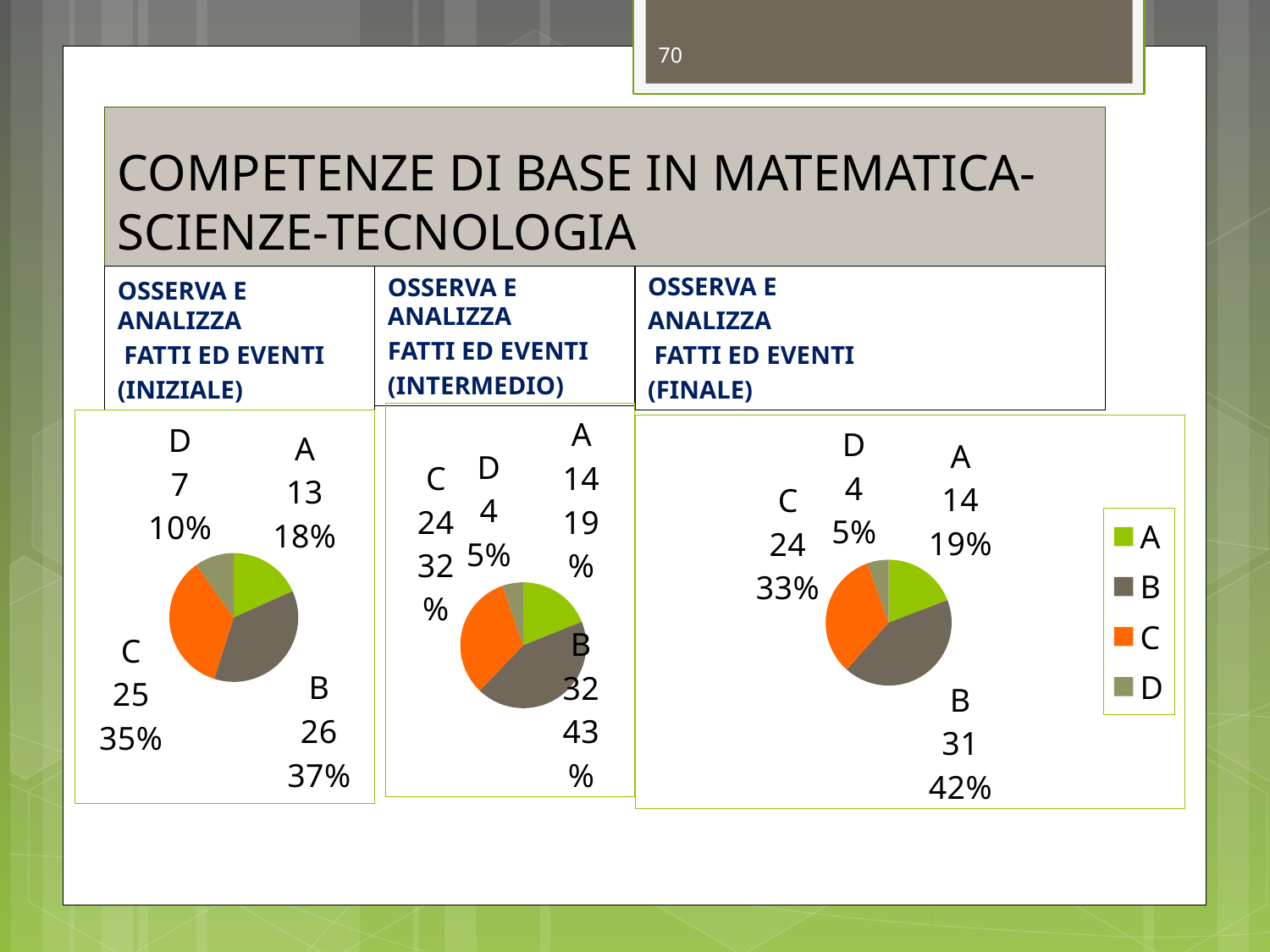
How many categories does the INIZIALE pie chart show? 4 In the INTERMEDIO pie chart, which category has the largest value? B In the INIZIALE pie chart, what percentage share does category C have? 35% In the INTERMEDIO pie chart, what value is shown for category B? 32 In the FINALE pie chart, which is larger, the value for C or the value for A? C In the FINALE pie chart, what value is shown for category C? 24 In the INIZIALE pie chart, which category has the smallest value? D In the FINALE pie chart, what is the difference between the values for B and A? 17 In the INTERMEDIO pie chart, what percentage share does category D have? 5% In the INIZIALE pie chart, what value is shown for category B? 26 What type of chart is used for the FINALE data? Pie chart In the FINALE pie chart, what percentage share does category B have? 42%